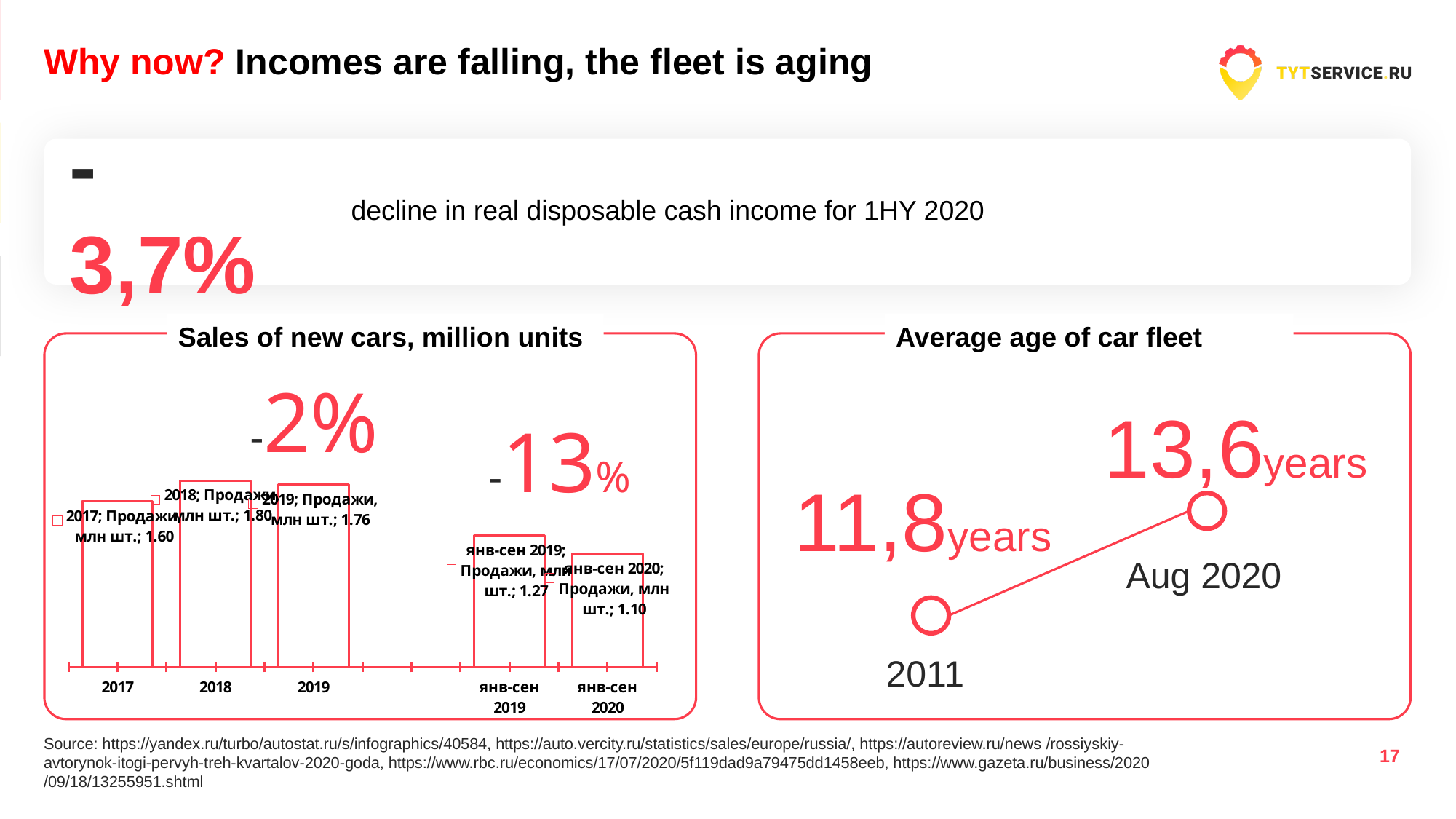
In the 'Average age of car fleet' chart, does the value rise or fall from 2011 to Aug 2020? rise In the 'Sales of new cars, million units' chart, which category has the lowest value? янв-сен 2020 In the 'Sales of new cars, million units' chart, what is the difference between the values for янв-сен 2019 and янв-сен 2020? 0.17 In the 'Average age of car fleet' chart, what is the value for Aug 2020? 13,6 years In the 'Sales of new cars, million units' chart, which is larger: the value for 2017 or the value for 2019? 2019 In the 'Sales of new cars, million units' chart, what is the value for 2017? 1.60 In the 'Sales of new cars, million units' chart, what is the value for янв-сен 2020? 1.10 What type of chart is the 'Sales of new cars, million units' chart? bar chart In the 'Average age of car fleet' chart, what is the value for 2011? 11,8 years In the 'Sales of new cars, million units' chart, which category has the highest value? 2018 How many bars are shown in the 'Sales of new cars, million units' chart? 5 In the 'Sales of new cars, million units' chart, what is the value for 2018? 1.80